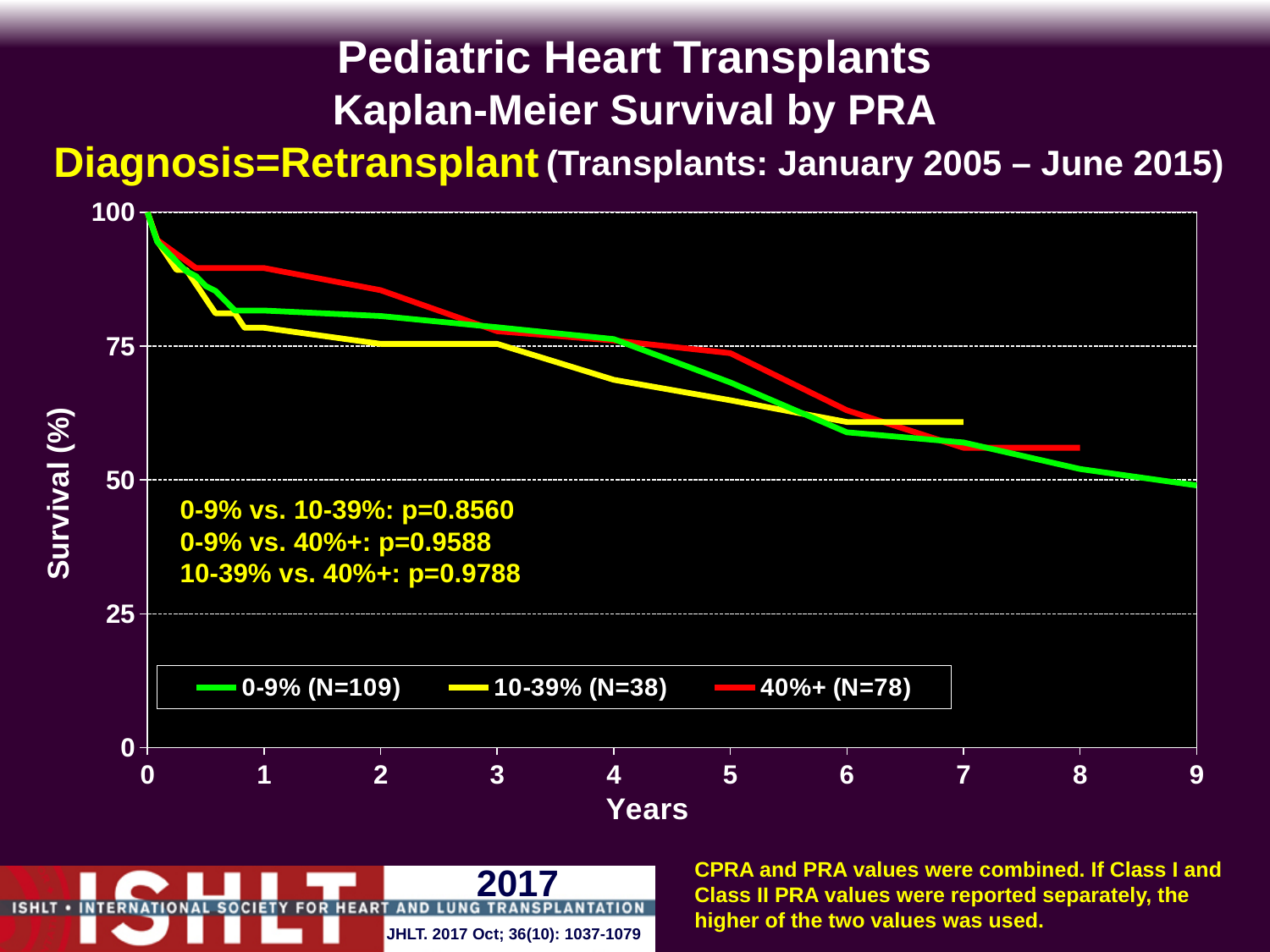
At year 1, which group has higher survival, 40%+ or 10-39%? 40%+ At year 2, which group has the highest survival? 40%+ Is the survival value for the 0-9% group at year 6 greater or less than 50? greater Is the survival value for the 40%+ group at year 8 greater or less than 50? greater Do the survival curves rise or fall as years increase? fall At year 5, which group has the lowest survival? 10-39% Is the survival value for the 10-39% group at year 5 greater or less than 75? less What p-value is shown for 0-9% vs. 40%+? p=0.9588 What is the N for the 0-9% group shown in the legend? N=109 What kind of chart is shown on the slide? line chart How many series does the legend list? 3